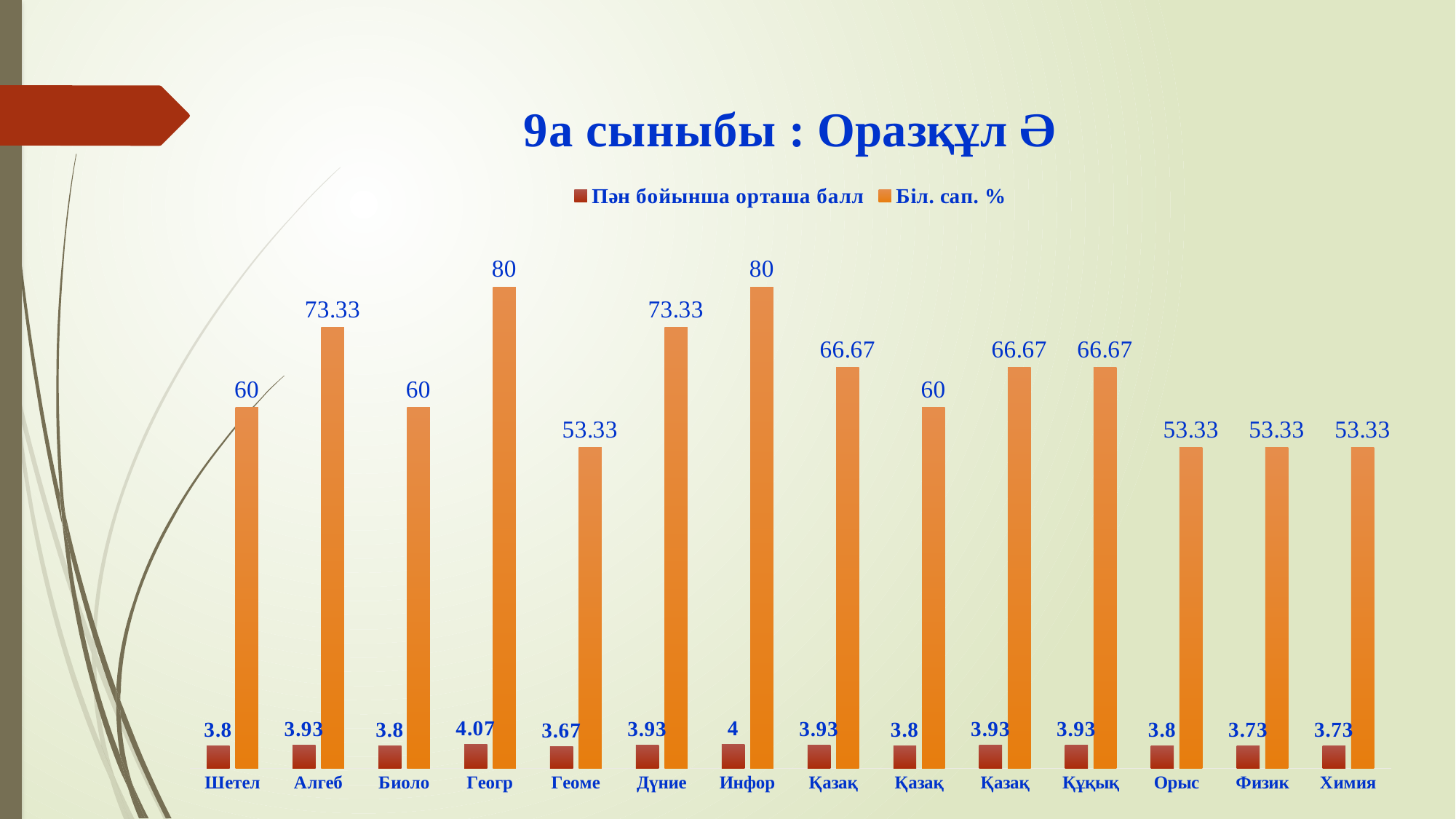
How many series does the legend list? 2 What kind of chart is shown on the slide? bar chart What is the difference in Біл. сап. % between Геогр and Шетел? 20 What is the value of Пән бойынша орташа балл for Құқық? 3.93 Which category has the lowest Пән бойынша орташа балл? Геоме What is the difference in Пән бойынша орташа балл between Инфор and Физик? 0.27 Which category has the highest Пән бойынша орташа балл? Геогр What is the value of Пән бойынша орташа балл for Геоме? 3.67 Which has a higher Біл. сап. %, Дүние or Орыс? Дүние What is the value of Біл. сап. % for Химия? 53.33 How many categories are shown on the x axis? 14 What is the value of Біл. сап. % for Алгеб? 73.33